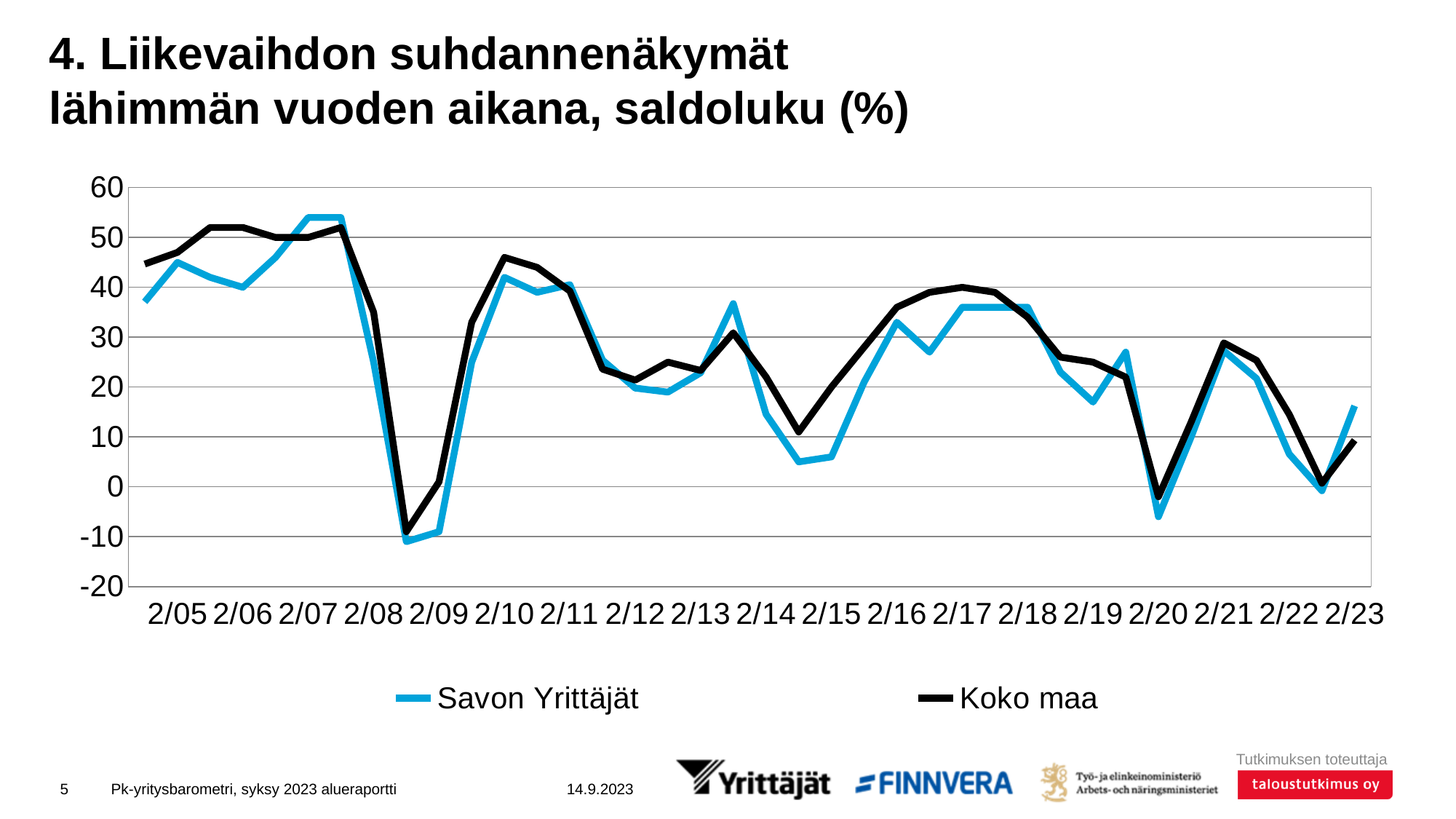
Is the value for Savon Yrittäjät at 2/15 greater or less than 10? less Is the value for Koko maa at 2/10 greater or less than 40? greater How many series does the legend list? 2 Is the value for Koko maa at 2/20 greater or less than 0? less At 2/23, which series has the higher value, Savon Yrittäjät or Koko maa? Savon Yrittäjät What kind of chart is shown on the slide? line chart Which series is drawn in blue? Savon Yrittäjät How many x-axis labels are shown on the chart? 19 Between 2/17 and 2/20, does the Koko maa line rise or fall? fall Which series is drawn in black? Koko maa At 2/05, which series has the higher value, Savon Yrittäjät or Koko maa? Koko maa